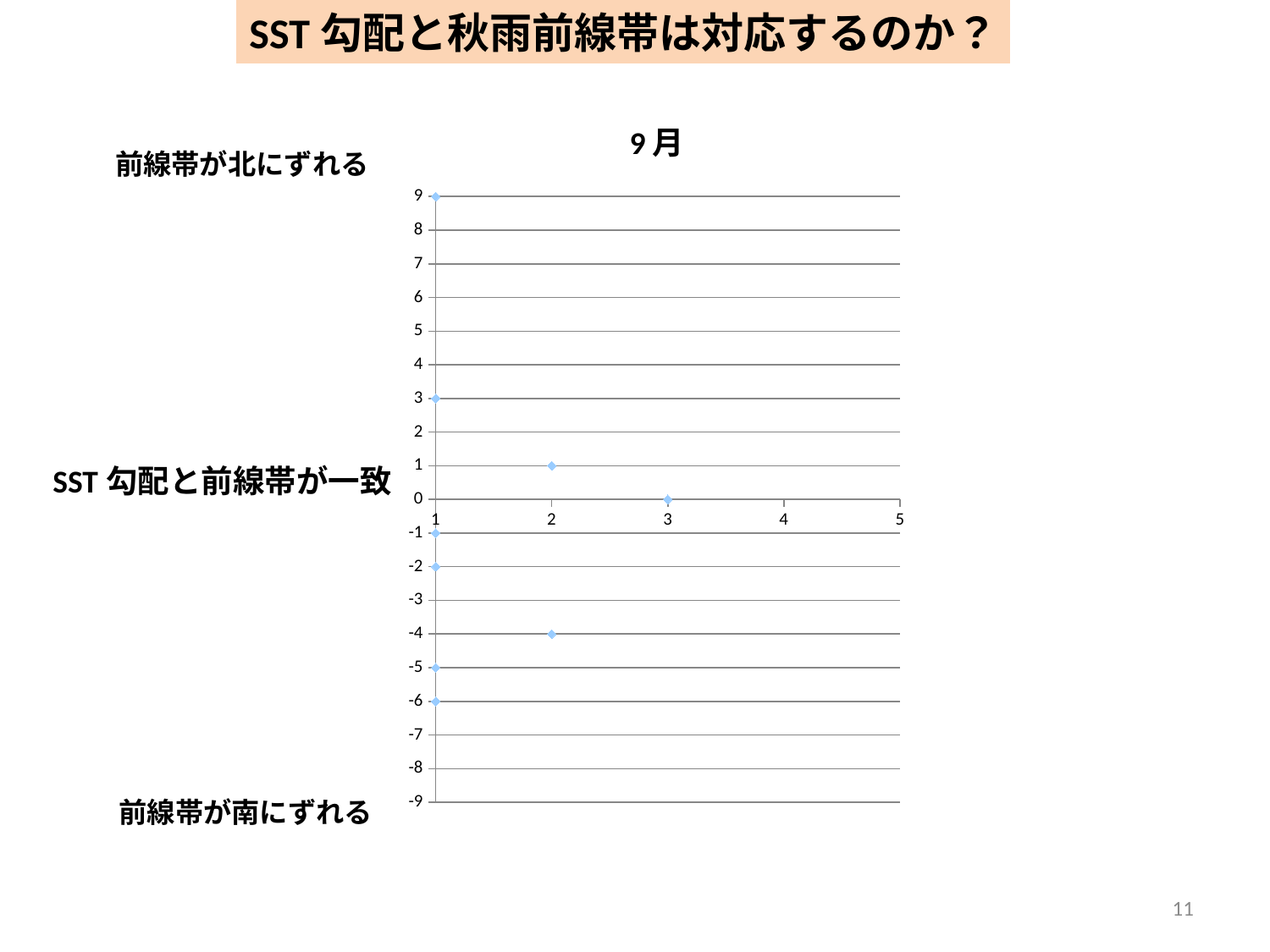
What is the highest y value of any plotted point? 9 What is the maximum value shown on the x axis? 5 Is the highest point at x = 1 greater or less than 5 on the y axis? greater What is the difference between the highest and lowest y values plotted at x = 1? 15 What is the title of the chart? 9月 What is the y value of the point plotted at x = 3? 0 What is the lowest y value of any plotted point? -6 How many data points are plotted in the chart? 9 How many points are plotted at x = 1? 6 How many points are plotted at x = 2? 2 What kind of chart is shown on the slide? scatter chart What is the highest y value among the points plotted at x = 2? 1